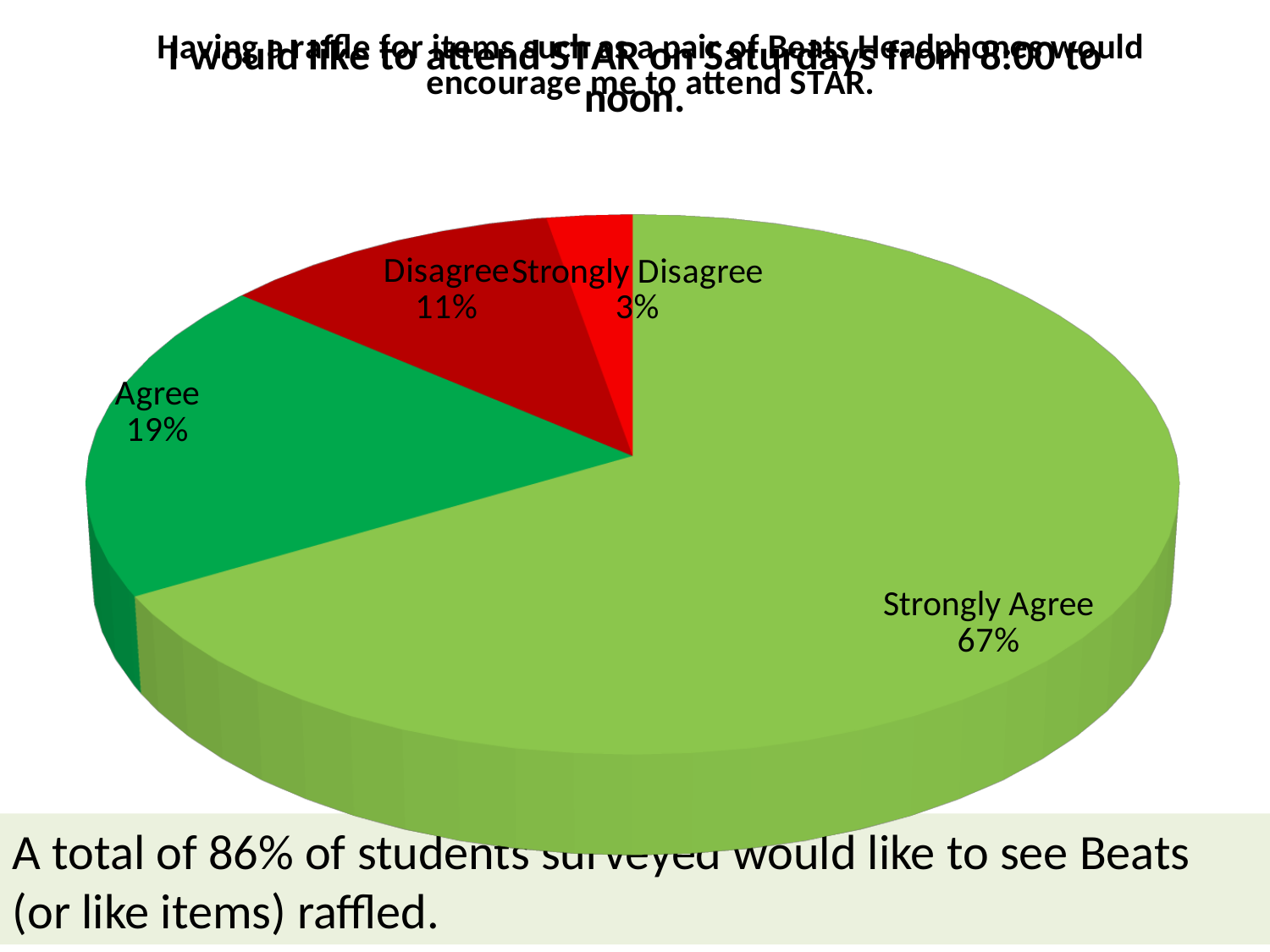
What kind of chart is shown on the slide? pie chart What percentage of the pie is labelled Strongly Agree? 67% What is the difference in percentage points between the Strongly Agree and Agree slices? 48 What colour is the Strongly Disagree slice? red What percentage of the pie is labelled Strongly Disagree? 3% What is the combined share of the Agree and Strongly Agree slices? 86% What percentage of the pie is labelled Disagree? 11% What percentage of the pie is labelled Agree? 19% Which slice of the pie is the smallest? Strongly Disagree Which slice of the pie is the largest? Strongly Agree Which slice is larger, Disagree or Agree? Agree How many slices does the pie chart have? 4